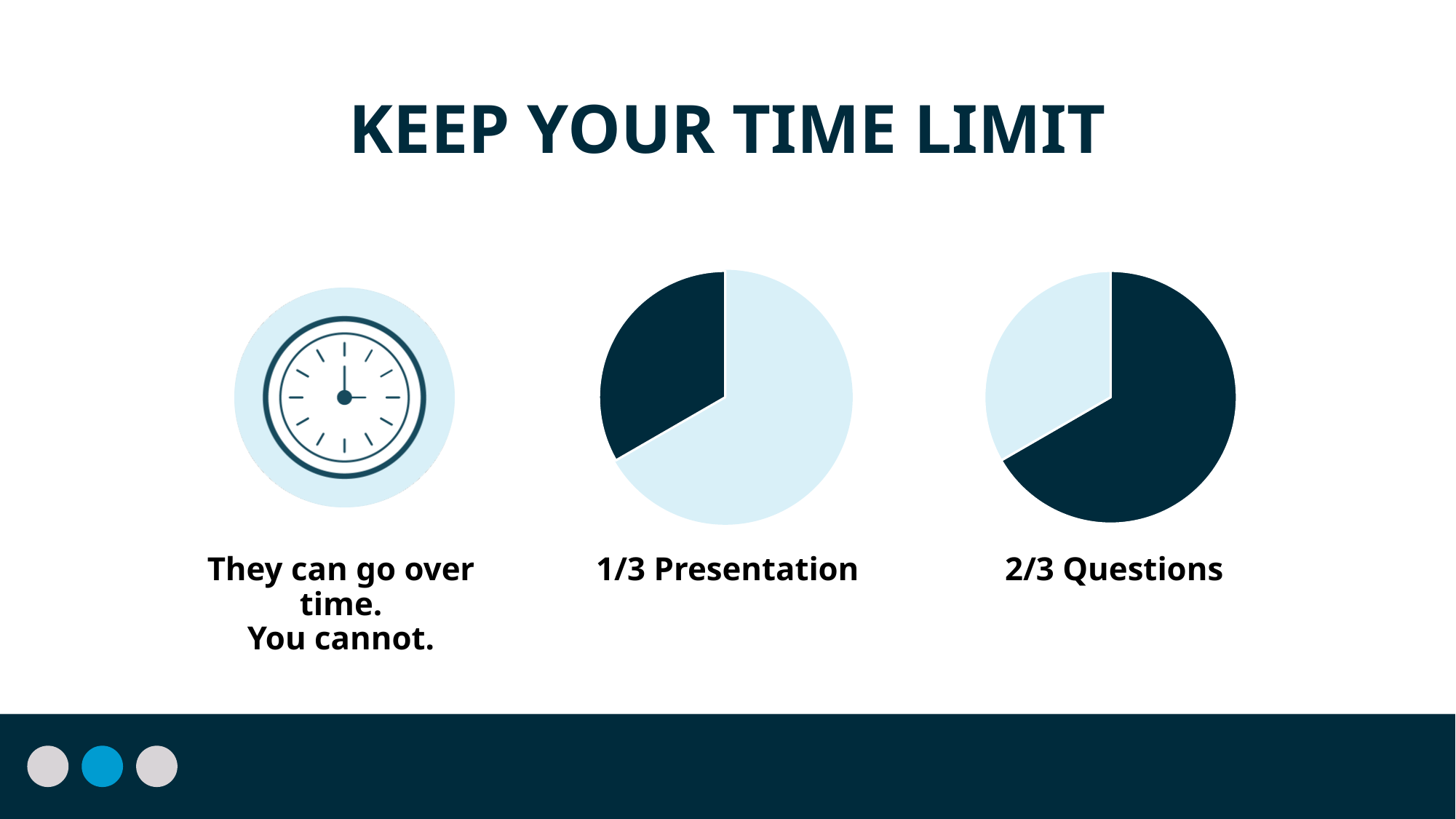
In the pie chart labelled "1/3 Presentation", what share of the pie does the dark slice represent? 1/3 Which pie chart has the larger dark slice, the one labelled "1/3 Presentation" or the one labelled "2/3 Questions"? 2/3 Questions What kind of chart is shown under the label "2/3 Questions"? pie chart In the pie chart labelled "2/3 Questions", which slice is larger, the dark slice or the light slice? the dark slice How many pie charts are on the slide? 2 In the pie chart labelled "2/3 Questions", what share of the pie does the dark slice represent? 2/3 What kind of chart is shown under the label "1/3 Presentation"? pie chart In the pie chart labelled "2/3 Questions", how many slices does the pie have? 2 In the pie chart labelled "1/3 Presentation", how many slices does the pie have? 2 What is the title of the slide containing the pie charts? KEEP YOUR TIME LIMIT In the pie chart labelled "1/3 Presentation", which slice is larger, the dark slice or the light slice? the light slice What label appears beneath the pie chart on the right of the slide? 2/3 Questions